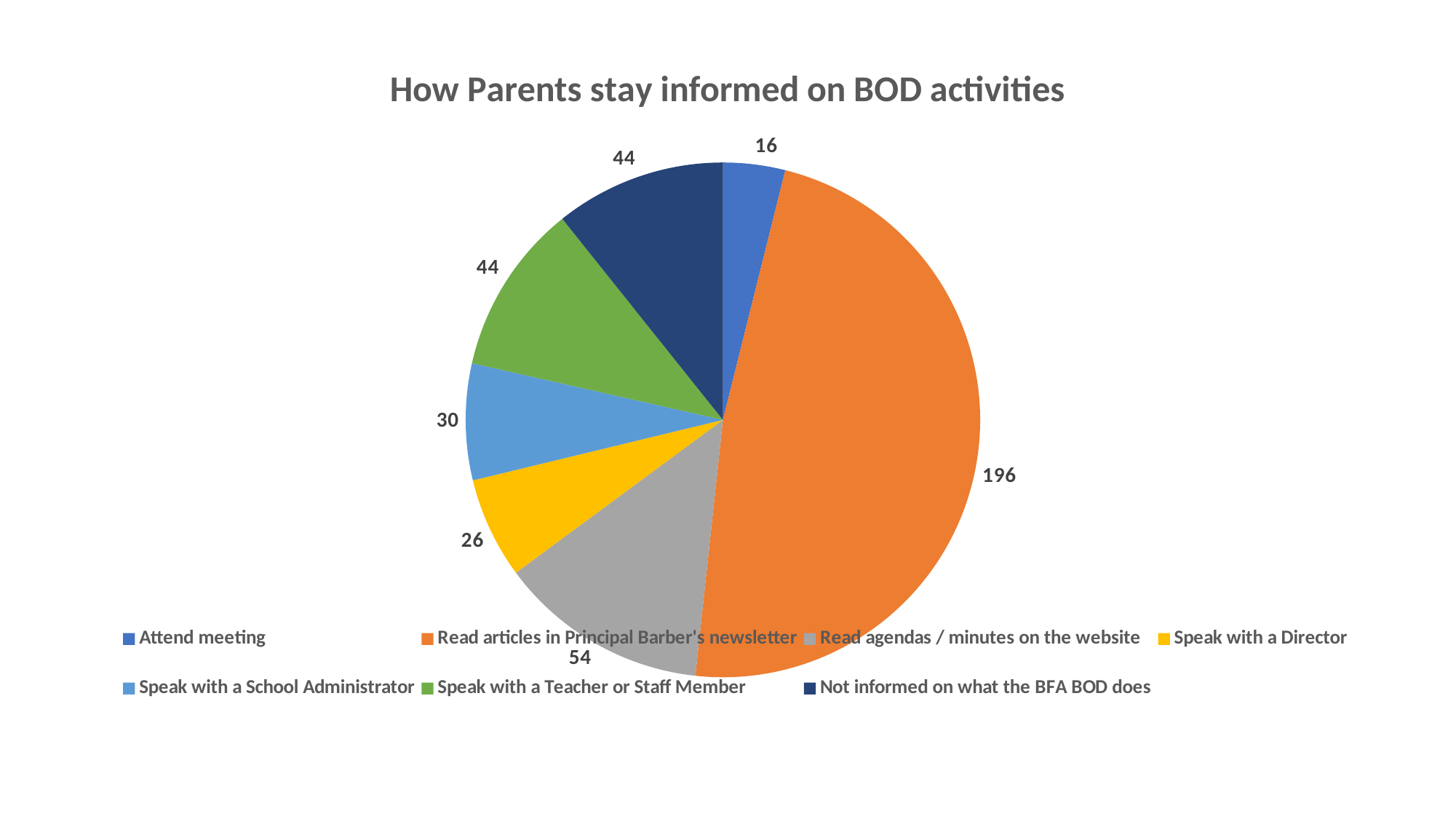
What is the title of the chart? How Parents stay informed on BOD activities Which is larger, the value for "Speak with a School Administrator" or the value for "Speak with a Director"? Speak with a School Administrator What is the difference between the values for "Read agendas / minutes on the website" and "Speak with a Director"? 28 How many categories does the pie chart have? 7 What type of chart is shown on the slide? pie chart What share of the pie does "Read articles in Principal Barber's newsletter" represent, to one decimal place? 47.8% What is the value for "Read agendas / minutes on the website"? 54 Which category has the smallest slice? Attend meeting What is the value for "Speak with a School Administrator"? 30 What is the total of all the values in the pie chart? 410 Which category has the largest slice? Read articles in Principal Barber's newsletter What is the value for "Read articles in Principal Barber's newsletter"? 196